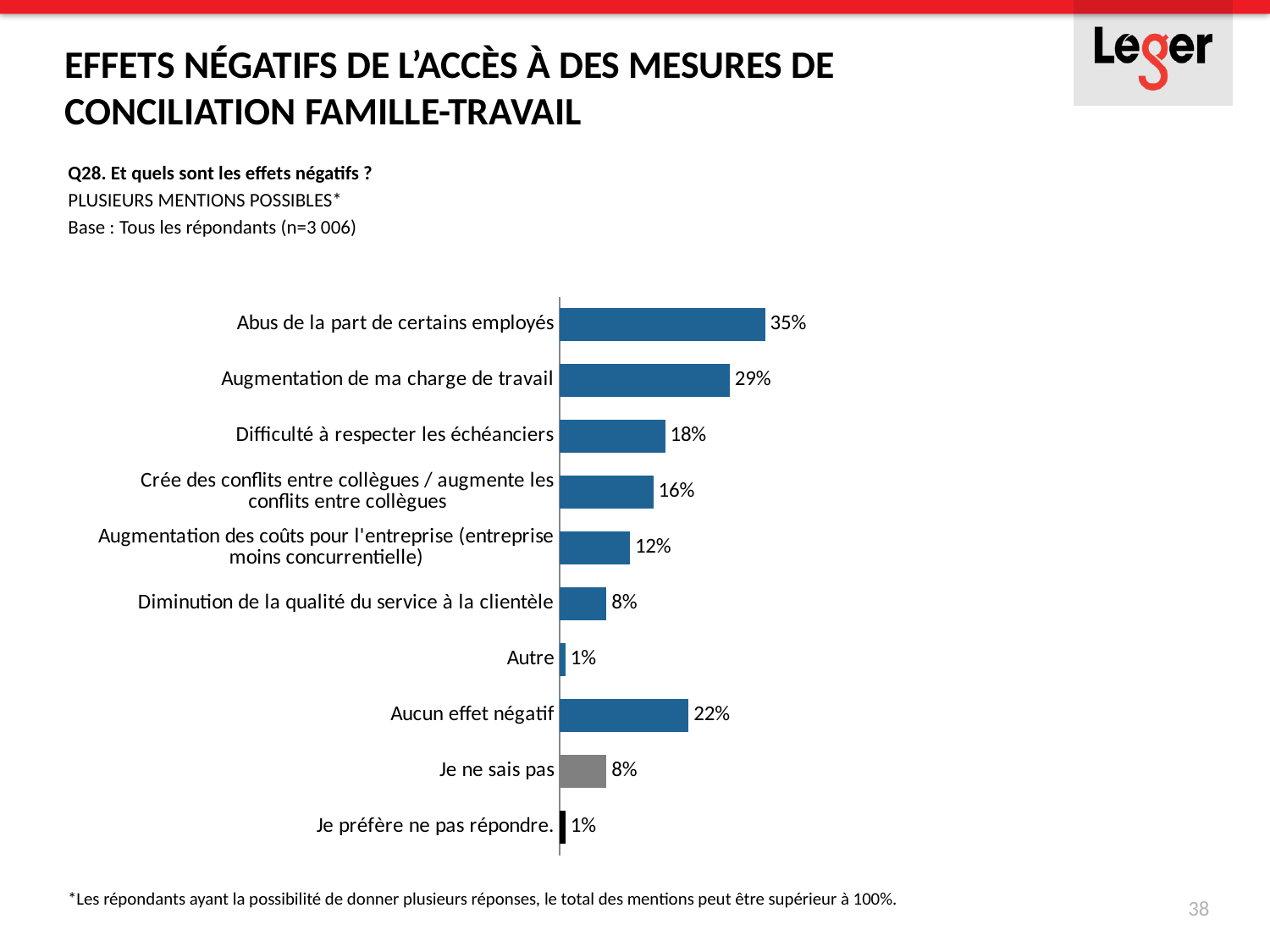
What is the value for "Abus de la part de certains employés"? 35% Which category has the highest value? Abus de la part de certains employés What is the difference between "Difficulté à respecter les échéanciers" and "Crée des conflits entre collègues / augmente les conflits entre collègues"? 2% What is the value for "Aucun effet négatif"? 22% What is the value for "Diminution de la qualité du service à la clientèle"? 8% What is the value for "Augmentation de ma charge de travail"? 29% What is the difference between "Abus de la part de certains employés" and "Augmentation de ma charge de travail"? 6% What kind of chart is shown on the slide? Bar chart Which is larger: "Aucun effet négatif" or "Difficulté à respecter les échéanciers"? Aucun effet négatif How many categories are shown in the chart? 10 Which is larger: "Augmentation des coûts pour l'entreprise (entreprise moins concurrentielle)" or "Je ne sais pas"? Augmentation des coûts pour l'entreprise (entreprise moins concurrentielle) What is the value for "Je préfère ne pas répondre."? 1%